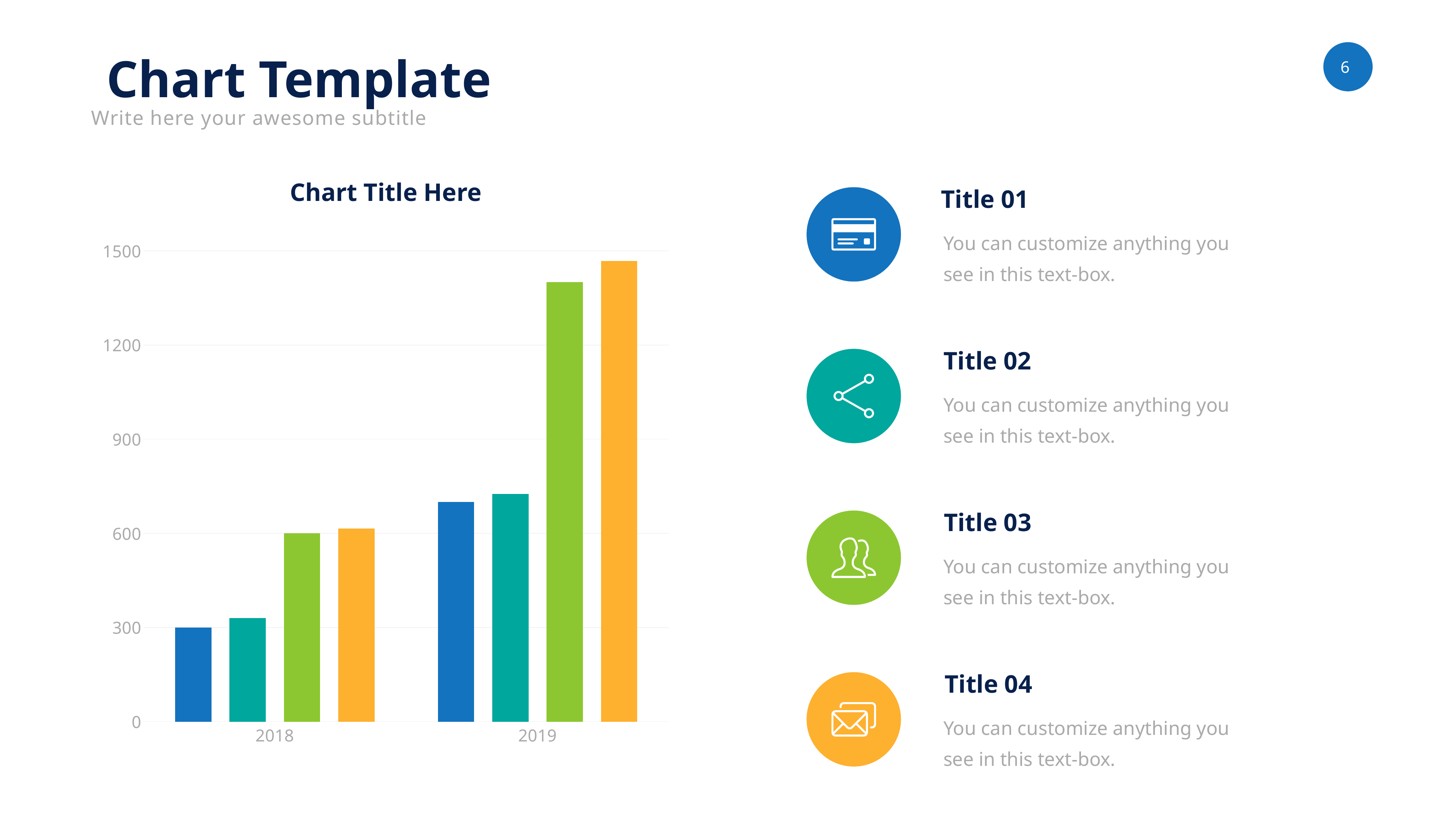
Which category on the x axis has the shortest bar? 2018 Is the value of the blue bar for 2019 greater or less than 900? less Is the value of the orange bar for 2019 greater or less than 1200? greater What type of chart is shown on the slide? bar chart Is the value of the teal bar for 2018 greater or less than 600? less What is the title of the chart? Chart Title Here What is the highest value shown on the vertical axis of the chart? 1500 Which category on the x axis has the tallest bar? 2019 Which is larger, the green bar for 2018 or the green bar for 2019? 2019 How many categories are shown on the x axis of the chart? 2 Do the bar values rise or fall from 2018 to 2019? rise